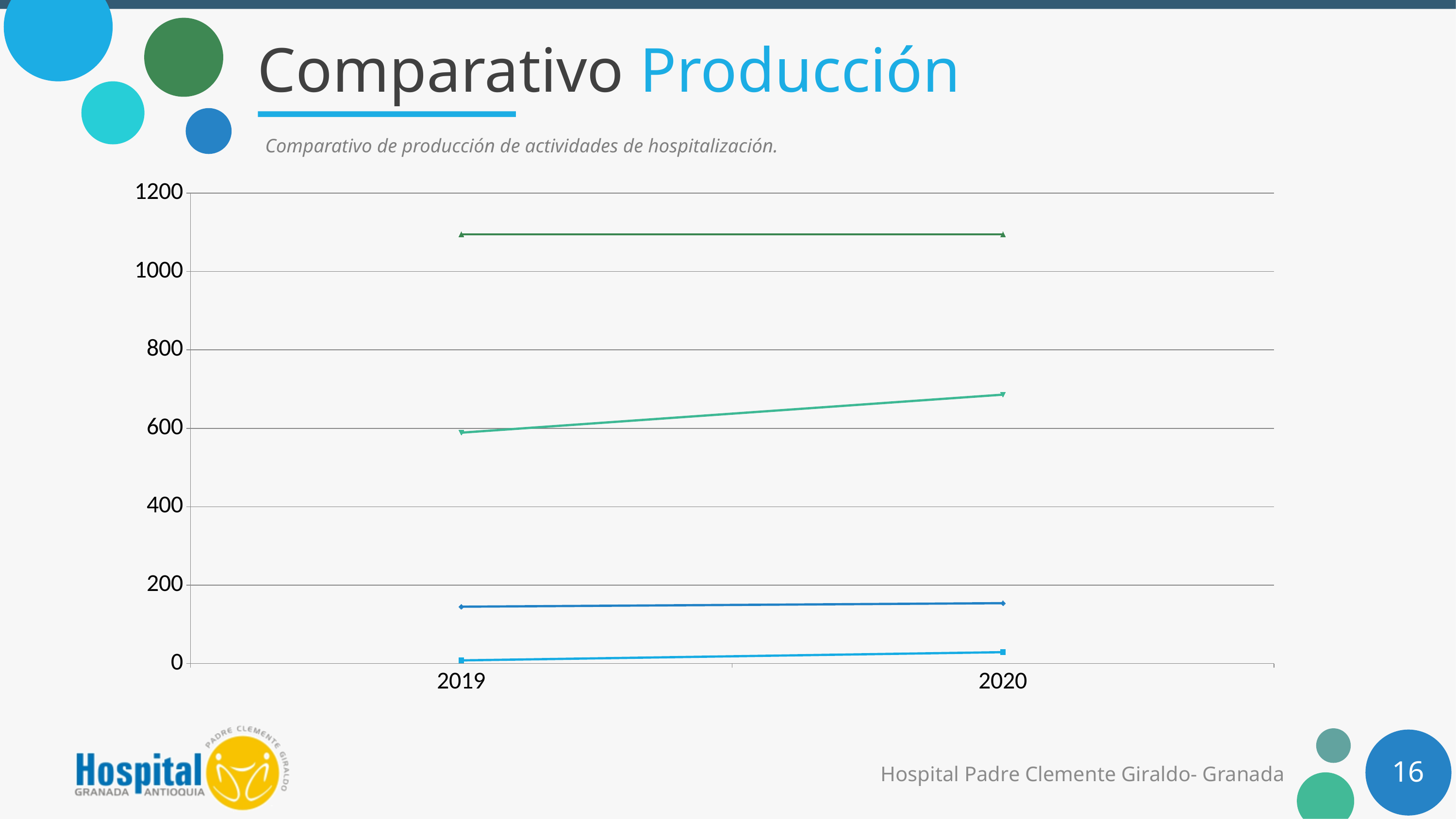
How many lines are plotted on the chart? 4 Is the value of the medium green line (inverted triangle markers) in 2020 greater or less than 600? greater What kind of chart is shown on the slide? line chart What is the highest value shown on the y axis of the chart? 1200 Is the value of the blue line (diamond markers) in 2019 greater or less than 200? less In 2020, which is larger: the dark green line (triangle markers) or the medium green line (inverted triangle markers)? the dark green line Does the medium green line (inverted triangle markers) rise or fall from 2019 to 2020? rise Which line is the highest on the chart? the dark green line with triangle markers Is the value of the dark green line (triangle markers) in 2019 greater or less than 1000? greater Which line is the lowest on the chart? the light blue line with square markers How many years are shown on the x axis of the chart? 2